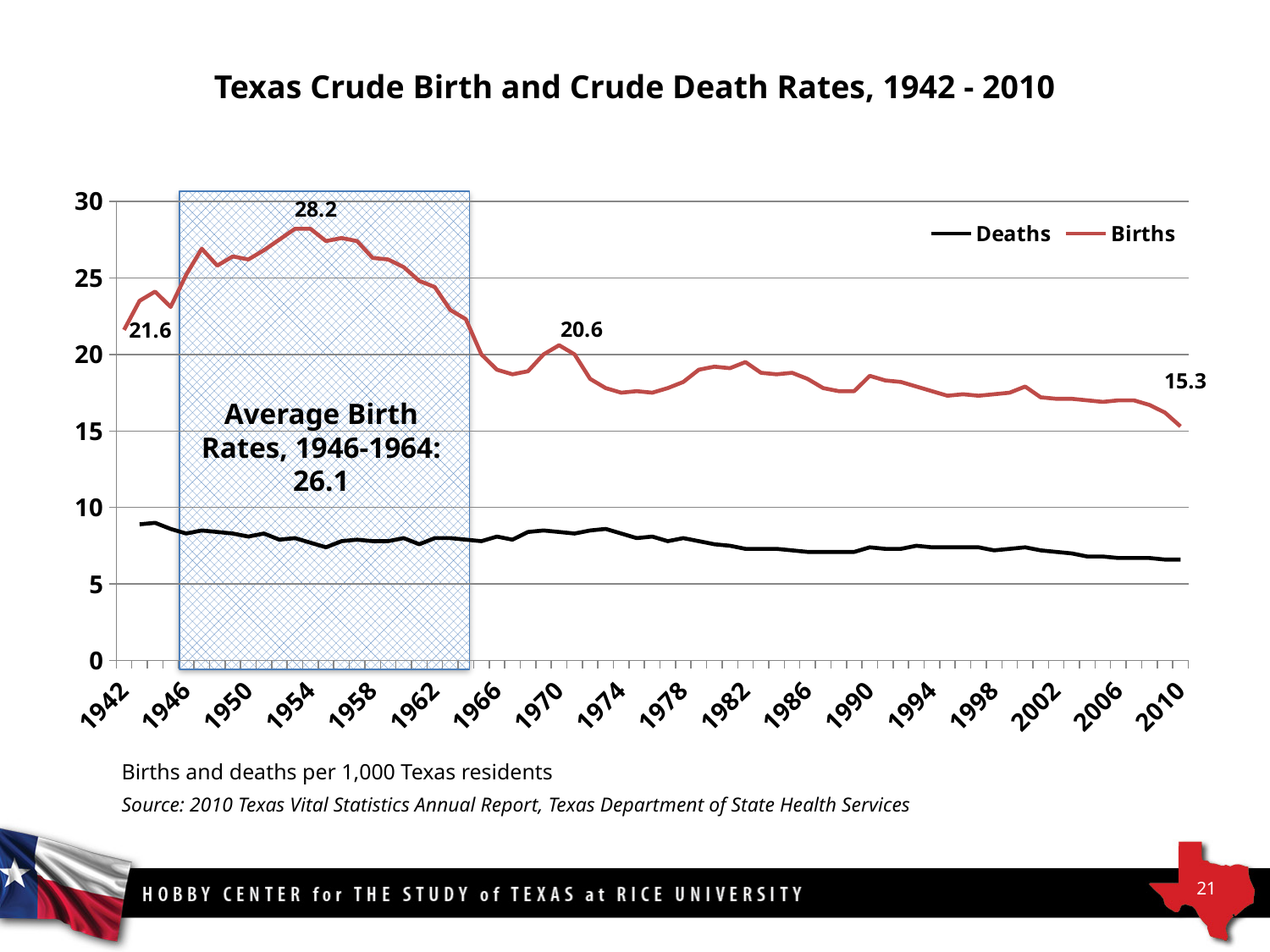
How many series does the legend list? 2 Does the Births line generally rise or fall from 1970 to 2010? fall What was the Texas crude birth rate in 1942? 21.6 What is the difference between the peak birth rate of 28.2 and the 2010 birth rate of 15.3? 12.9 What is the highest labeled value on the Births line? 28.2 According to the annotation on the chart, what was the average birth rate for 1946-1964? 26.1 What was the Texas crude birth rate in 2010? 15.3 By how much did the birth rate fall from 1942 (21.6) to 2010 (15.3)? 6.3 What kind of chart is shown on the slide? Line chart Is the death rate in 2010 greater or less than 10? less What is the labeled birth rate value around 1970? 20.6 In 2010, which series has the higher value, Births or Deaths? Births